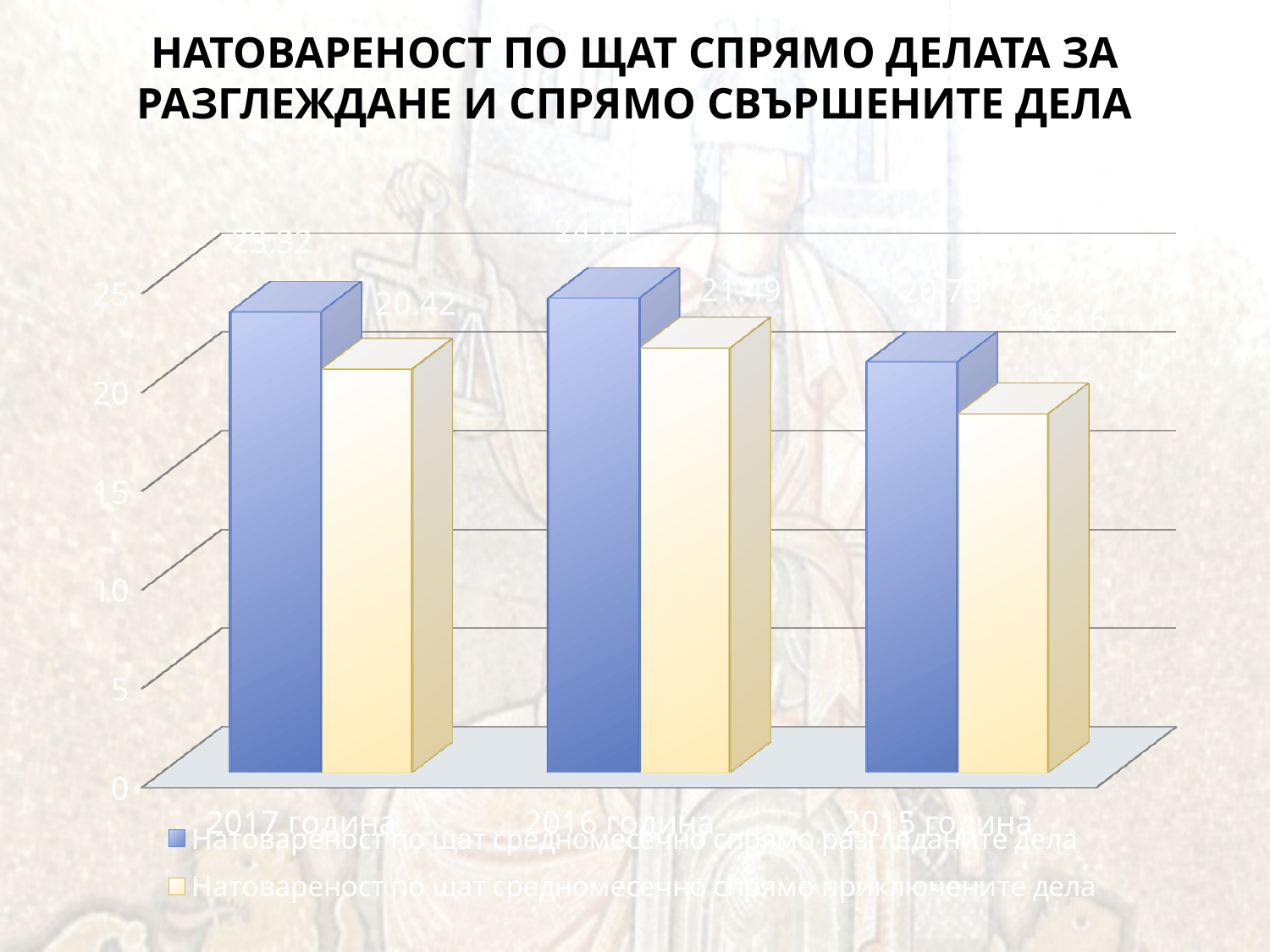
What is the value for 2015 година in the series 'Натовареност по щат средномесечно спрямо приключените дела'? 18.16 How many series does the legend list? 2 What is the value for 2016 година in the series 'Натовареност по щат средномесечно спрямо приключените дела'? 21.49 What is the value for 2015 година in the series 'Натовареност по щат средномесечно спрямо разгледаните дела'? 20.78 What is the value for 2017 година in the series 'Натовареност по щат средномесечно спрямо разгледаните дела'? 23.32 Which year has the highest value in the series 'Натовареност по щат средномесечно спрямо разгледаните дела'? 2016 година For 2015 година, which series has the larger value: 'спрямо разгледаните дела' or 'спрямо приключените дела'? спрямо разгледаните дела What is the value for 2017 година in the series 'Натовареност по щат средномесечно спрямо приключените дела'? 20.42 What is the difference between the two series values for 2017 година? 2.90 How many years are shown on the x axis of the chart? 3 Which year has the lowest value in the series 'Натовареност по щат средномесечно спрямо приключените дела'? 2015 година Is the value for 2015 година in the series 'Натовареност по щат средномесечно спрямо приключените дела' greater or less than 20? less